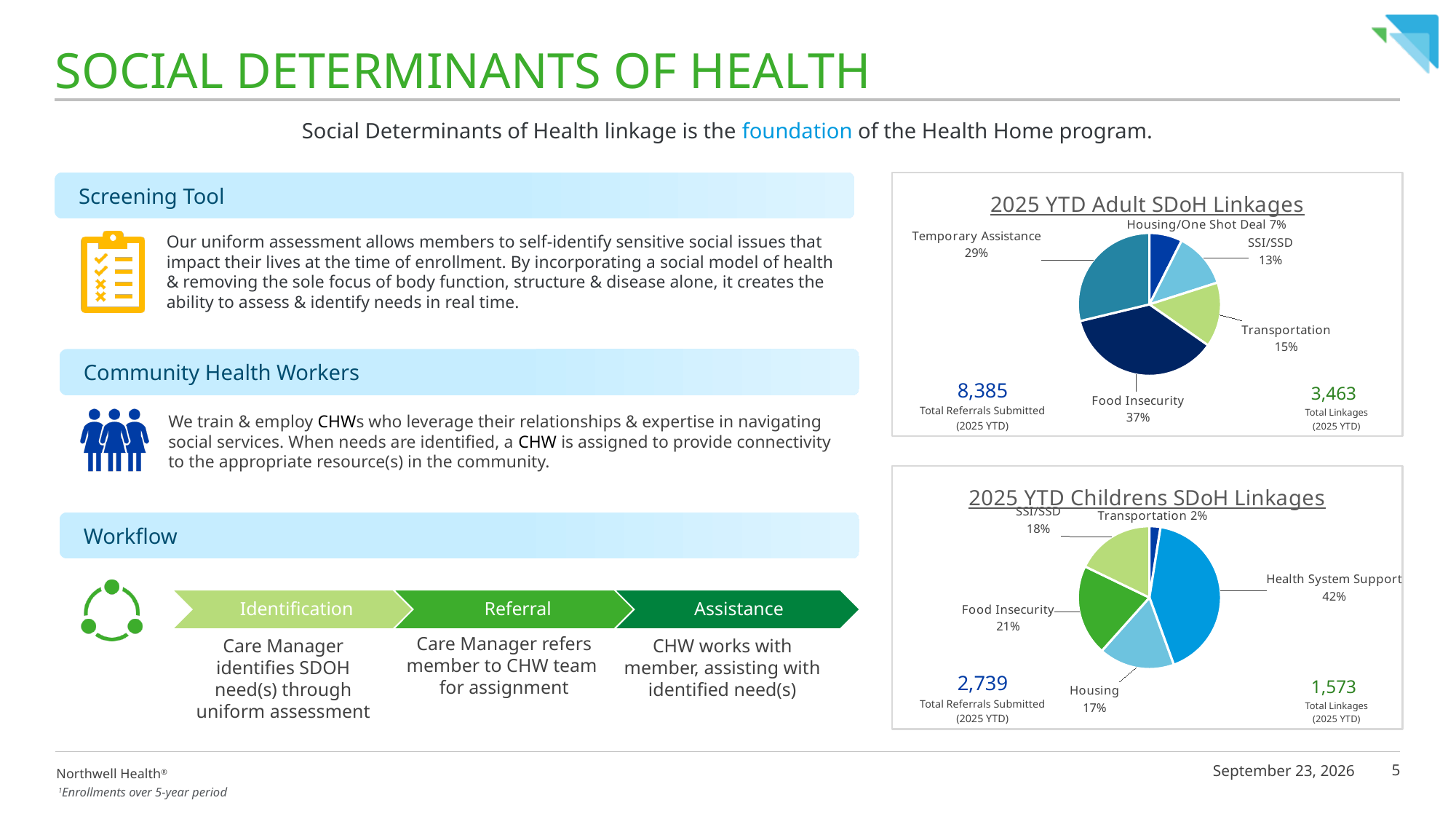
In the 2025 YTD Adult SDoH Linkages chart, which category has the largest share? Food Insecurity In the 2025 YTD Childrens SDoH Linkages chart, what is the difference in percentage points between Health System Support and SSI/SSD? 24 What type of chart is the 2025 YTD Adult SDoH Linkages chart? Pie chart In the 2025 YTD Childrens SDoH Linkages chart, what share is Transportation? 2% In the 2025 YTD Childrens SDoH Linkages chart, what share is Health System Support? 42% In the 2025 YTD Childrens SDoH Linkages chart, which category has the smallest share? Transportation In the 2025 YTD Adult SDoH Linkages chart, what share is Temporary Assistance? 29% In the 2025 YTD Adult SDoH Linkages chart, which category has the smallest share? Housing/One Shot Deal In the 2025 YTD Adult SDoH Linkages chart, what share is Food Insecurity? 37% In the 2025 YTD Childrens SDoH Linkages chart, which is larger, Food Insecurity or Housing? Food Insecurity In the 2025 YTD Adult SDoH Linkages chart, what is the difference in percentage points between Transportation and SSI/SSD? 2 In the 2025 YTD Adult SDoH Linkages chart, how many categories are shown? 5